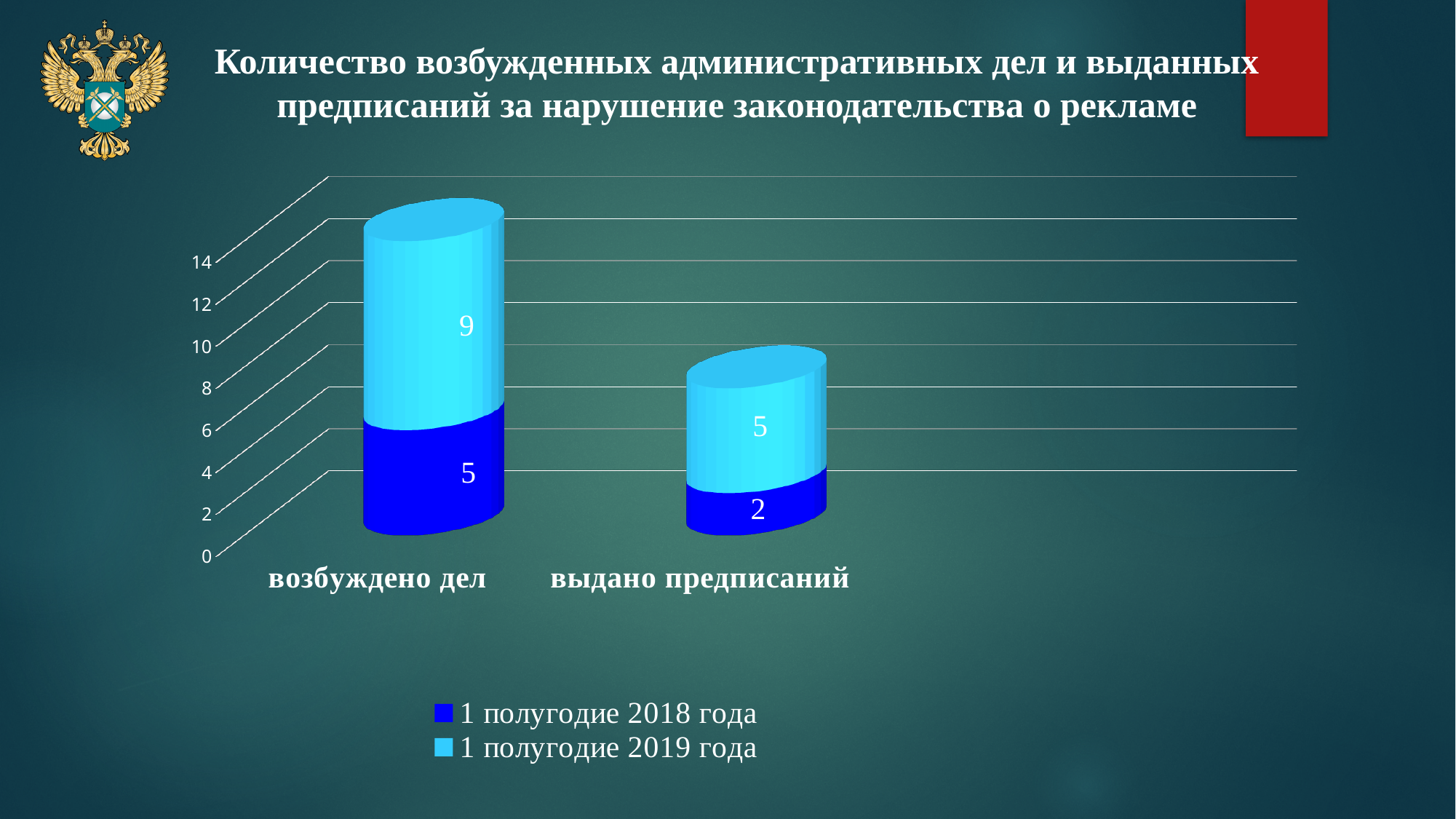
Which category has the higher total stacked value? возбуждено дел What is the value for «выдано предписаний» in the «1 полугодие 2018 года» series? 2 What kind of chart is shown on the slide? Stacked bar chart What is the value for «возбуждено дел» in the «1 полугодие 2019 года» series? 9 How many categories are shown on the x axis? 2 What is the total of the stacked bar for «возбуждено дел»? 14 How many series does the legend list? 2 Which is larger: the «1 полугодие 2018 года» value for «возбуждено дел» or for «выдано предписаний»? возбуждено дел What is the difference between the «1 полугодие 2019 года» and «1 полугодие 2018 года» values for «возбуждено дел»? 4 What is the value for «выдано предписаний» in the «1 полугодие 2019 года» series? 5 What is the value for «возбуждено дел» in the «1 полугодие 2018 года» series? 5 What is the total of the stacked bar for «выдано предписаний»? 7